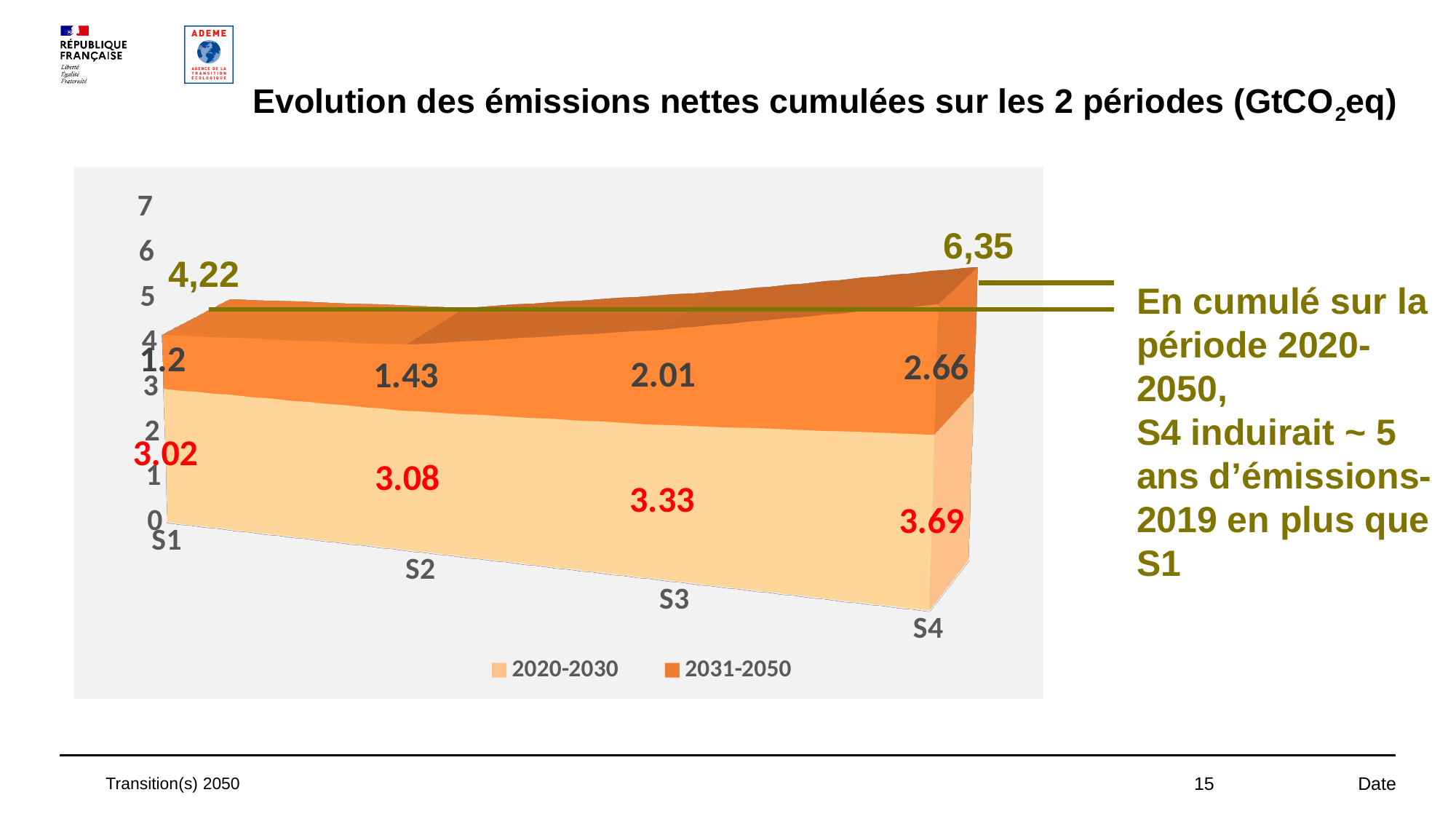
What is the value of the 2031-2050 series for S2? 1.43 What kind of chart is shown on the slide? Stacked area chart What are the two series named in the legend? 2020-2030 and 2031-2050 Which is larger for the 2031-2050 series: S3 or S2? S3 How many series does the legend list? 2 Which scenario has the lowest value for the 2031-2050 series? S1 What is the difference between the 2020-2030 values for S4 and S1? 0.67 Which scenario has the highest value for the 2020-2030 series? S4 What is the value of the 2020-2030 series for S3? 3.33 Do the values of the 2031-2050 series rise or fall from S1 to S4? Rise What is the cumulative total shown for S4 over both periods? 6,35 How many scenarios are shown on the x axis? 4